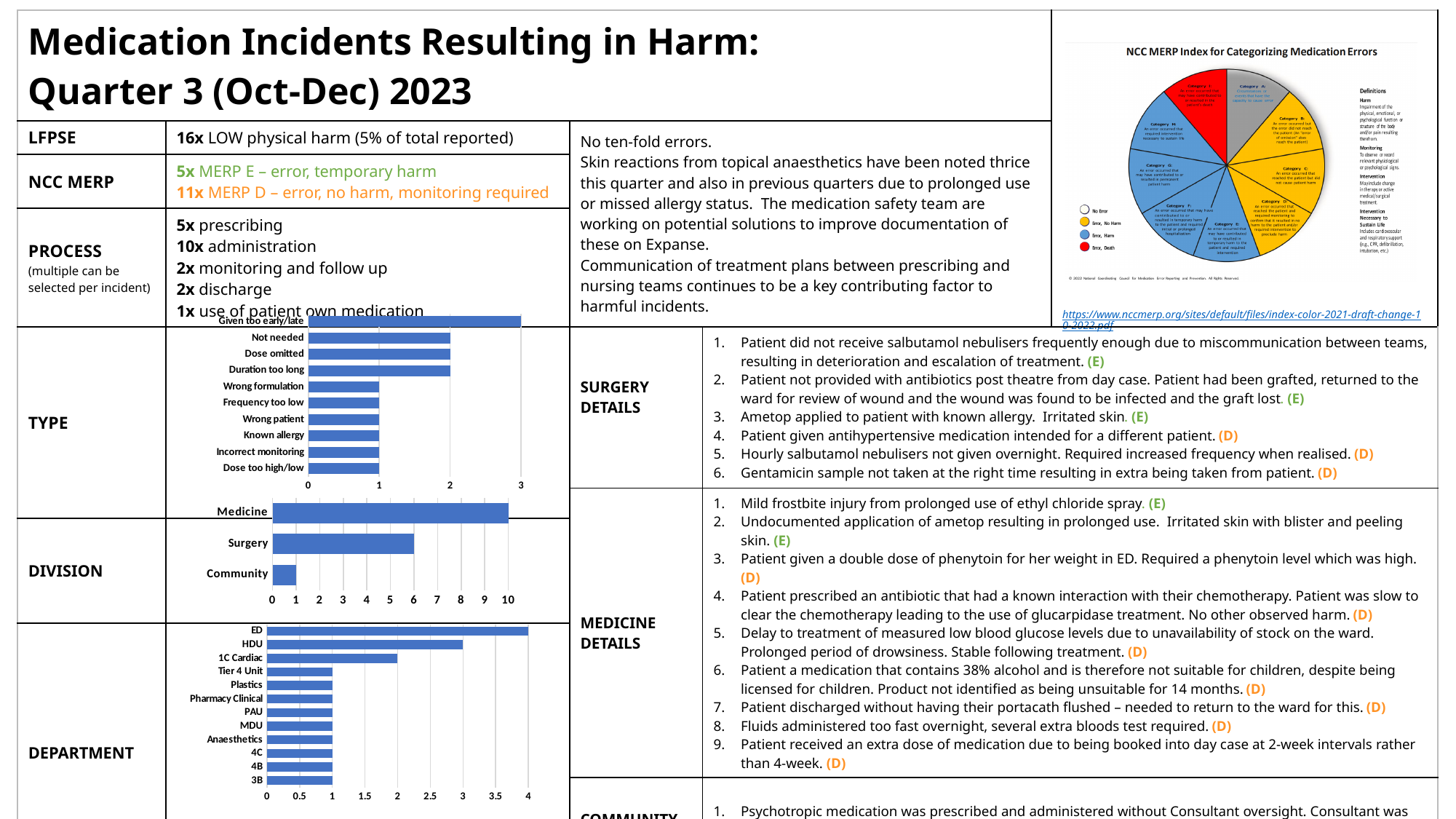
In the DEPARTMENT chart, what is the value for 1C Cardiac? 2 In the DIVISION chart, what is the difference between the values for Medicine and Surgery? 4 How many departments are listed in the DEPARTMENT chart? 12 In the DIVISION chart, which division has the lowest value? Community In the DEPARTMENT chart, what is the value for HDU? 3 In the DIVISION chart, what is the value for Surgery? 6 In the TYPE chart, which type has the highest value? Given too early/late What kind of chart is the DIVISION chart? Bar chart In the DIVISION chart, what is the value for Medicine? 10 In the TYPE chart, which is larger, the value for Not needed or the value for Wrong patient? Not needed In the TYPE chart, what is the value for Dose omitted? 2 In the DEPARTMENT chart, which department has the highest value? ED